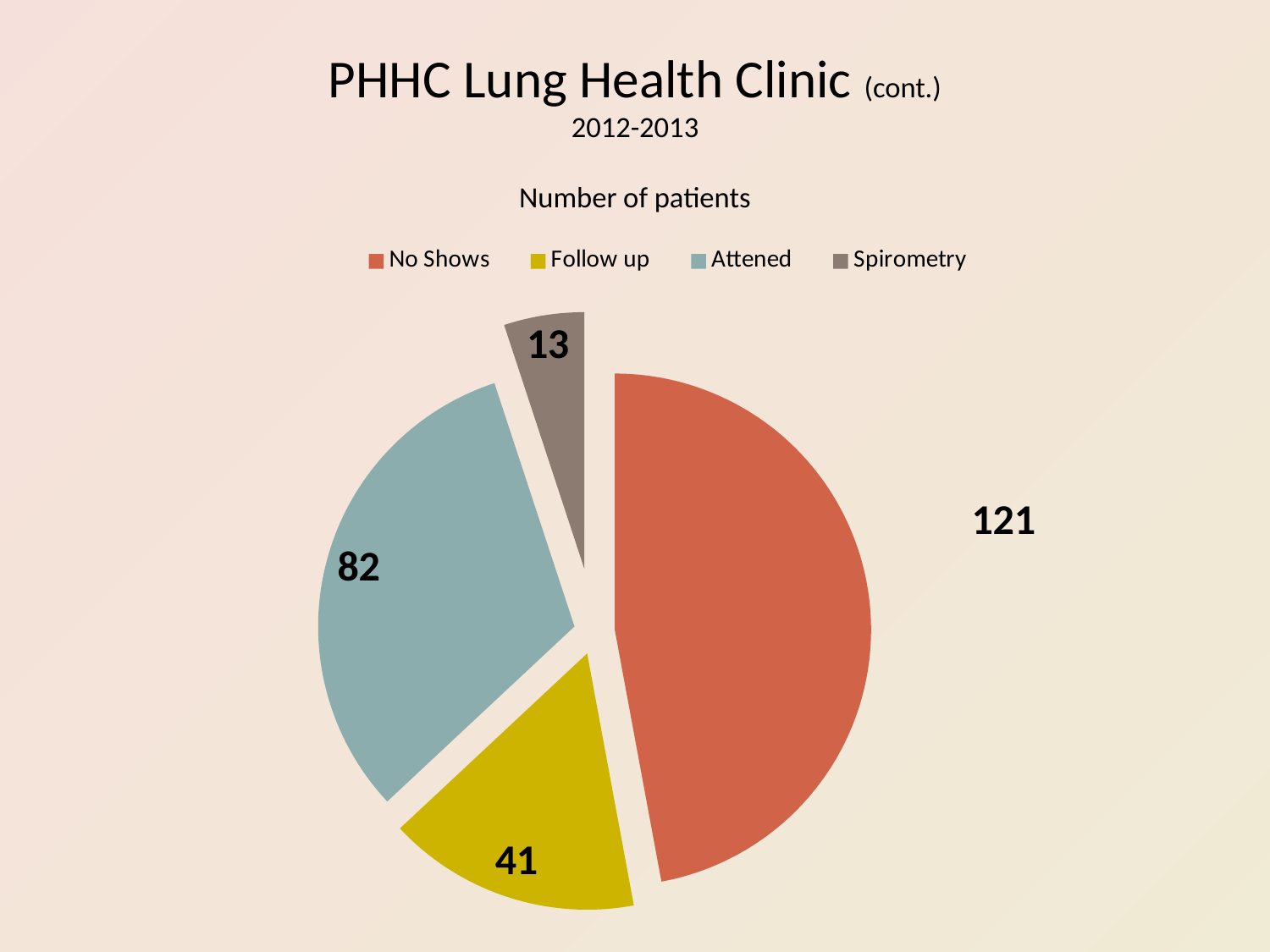
What kind of chart is shown on the slide? pie chart How many slices does the pie chart have? 4 Which is larger, the Follow up value or the Attened value? Attened Which category has the smallest slice? Spirometry What is the chart's title? Number of patients What is the value for Attened? 82 What is the value for Follow up? 41 How many entries does the legend list? 4 Which category has the largest slice? No Shows What is the difference between the No Shows value and the Attened value? 39 What is the value for Spirometry? 13 What is the value for No Shows? 121